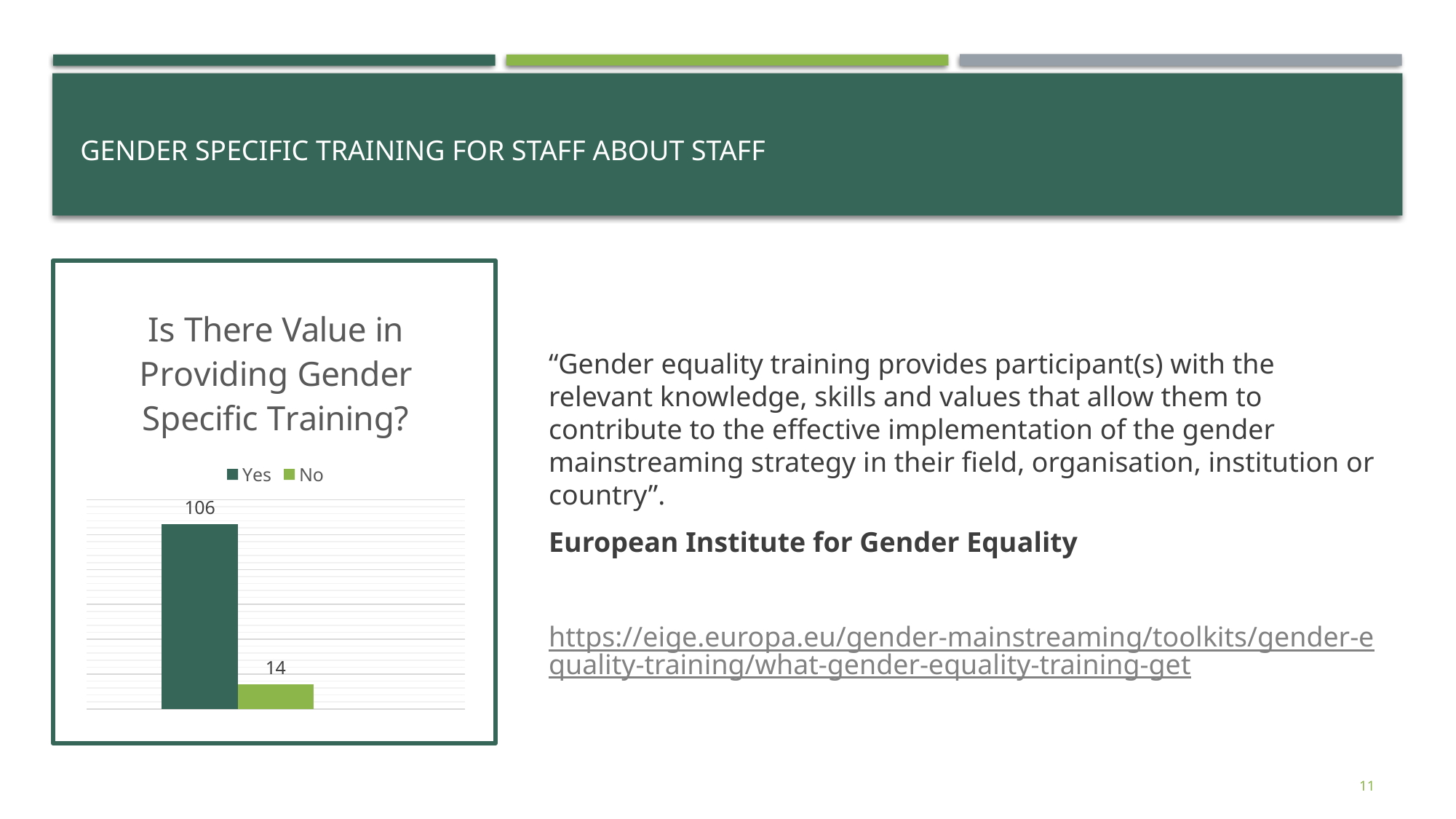
What is the total of the Yes and No values combined? 120 How many series does the legend list? 2 Which series has the lowest value in the chart? No What is the difference between the Yes and No values? 92 Which is larger, the value for Yes or the value for No? Yes What is the title of the chart? Is There Value in Providing Gender Specific Training? How many bars are plotted in the chart? 2 What is the value for No in the chart? 14 What colour is the No bar in the chart? Light green What kind of chart is shown on the slide? Bar chart What is the value for Yes in the chart? 106 Which series has the highest value in the chart? Yes